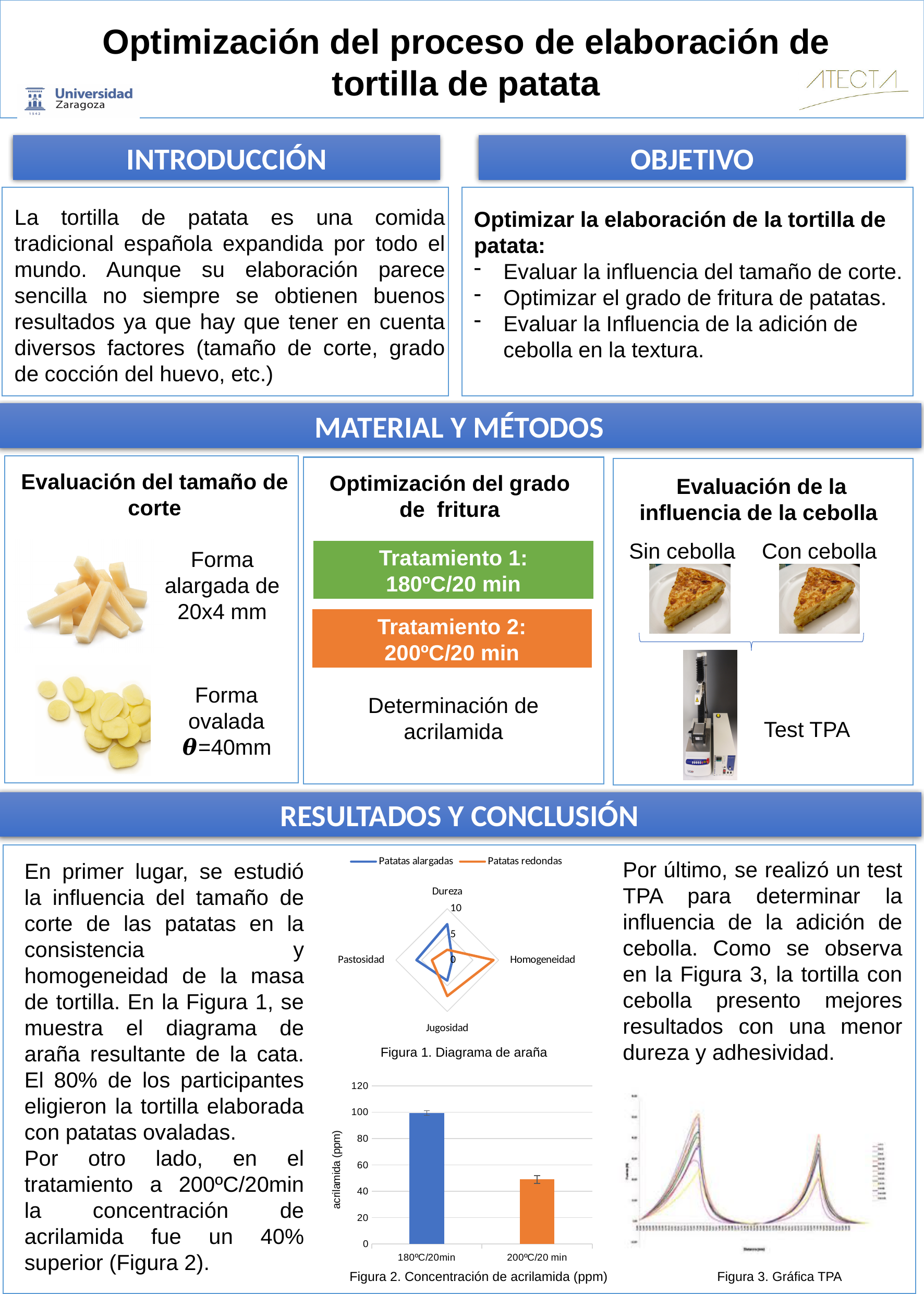
In Figura 2 (Concentración de acrilamida), is the value for 200ºC/20 min greater or less than 60? less What kind of chart is Figura 1 (Diagrama de araña)? radar chart How many axes (categories) does the radar chart in Figura 1 have? 4 In Figura 1 (Diagrama de araña), which series has the higher Jugosidad value, Patatas alargadas or Patatas redondas? Patatas redondas How many bars are shown in Figura 2 (Concentración de acrilamida)? 2 In Figura 1 (Diagrama de araña), which series has the higher Pastosidad value, Patatas alargadas or Patatas redondas? Patatas alargadas What kind of chart is Figura 2 (Concentración de acrilamida)? bar chart What is the y-axis label of the bar chart in Figura 2? acrilamida (ppm) In Figura 1 (Diagrama de araña), is the Dureza value for Patatas alargadas greater or less than 5? greater In Figura 2 (Concentración de acrilamida), which treatment has the highest acrylamide concentration? 180ºC/20min How many series does the legend of Figura 1 (Diagrama de araña) list? 2 In Figura 1 (Diagrama de araña), is the Homogeneidad value for Patatas redondas greater or less than 5? greater